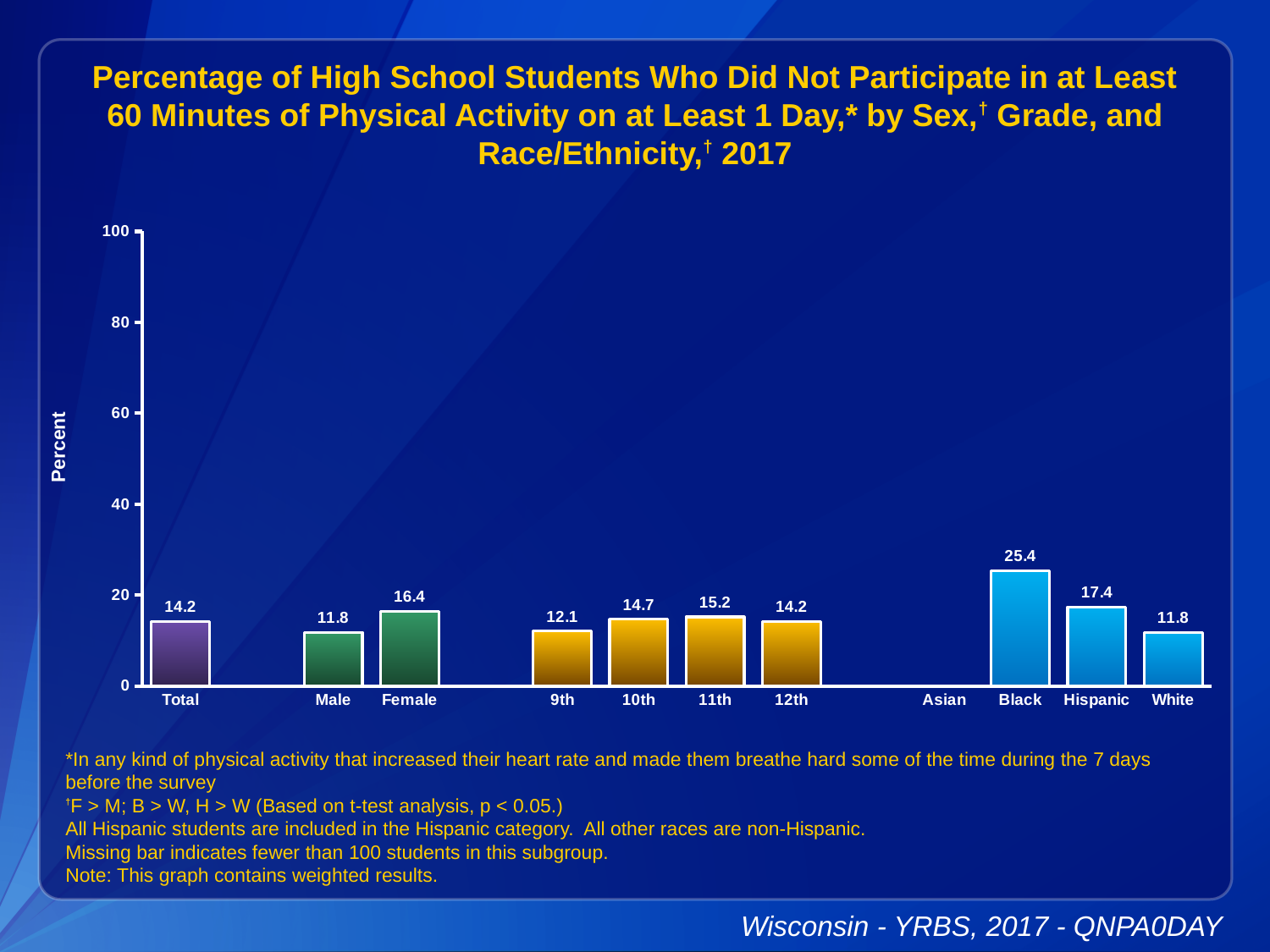
What is the difference between the Female and Male values? 4.6 Is the value for Black greater or less than 20? greater Which race/ethnicity category has no bar shown? Asian Which is larger, the value for Hispanic or the value for White? Hispanic Which category has the highest value? Black What is the value for 9th grade? 12.1 What is the value for Female? 16.4 Which grade has the lowest value? 9th What kind of chart is shown? bar chart How many bars are plotted on the chart? 10 What is the value for Black? 25.4 Do the values rise or fall from 9th grade to 11th grade? rise